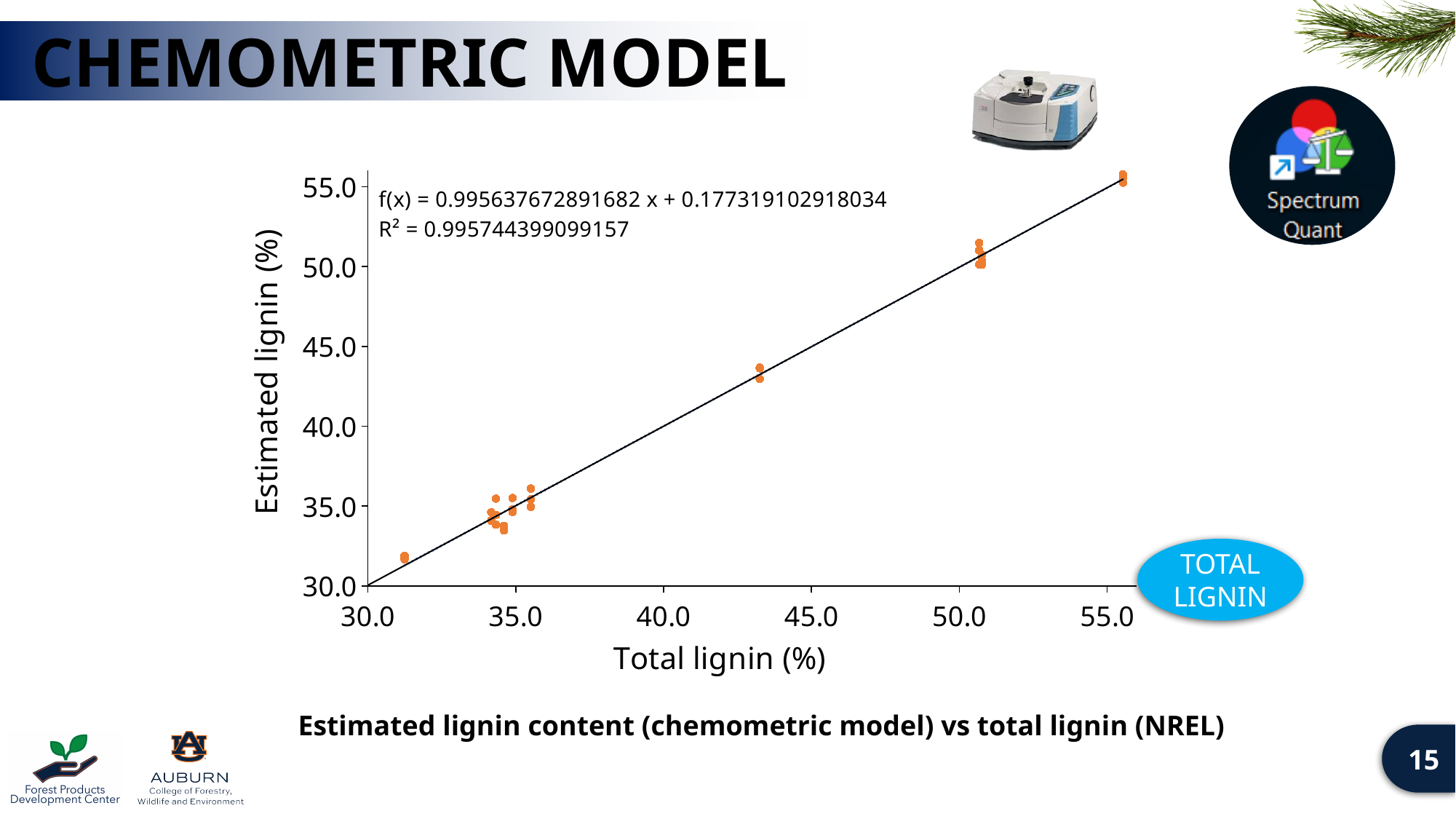
Is the estimated lignin value for the lowest point (near 31 % total lignin) greater or less than 35.0? less Do the estimated lignin values rise or fall as total lignin increases along the x axis? Rise What is the trendline equation printed on the chart? f(x) = 0.995637672891682 x + 0.177319102918034 Is the estimated lignin value for the points at about 50.5 % total lignin greater or less than 55.0? less What is the title of the x axis of the chart? Total lignin (%) Is the estimated lignin value for the points at about 55 % total lignin greater or less than 50.0? greater What kind of chart is shown on the slide? Scatter chart Which group of points has the highest estimated lignin: those near 55 % total lignin or those near 35 % total lignin? Those near 55 % total lignin What is the lowest value shown on the x axis of the chart? 30.0 What R² value is printed on the chart? 0.995744399099157 What is the title of the y axis of the chart? Estimated lignin (%)